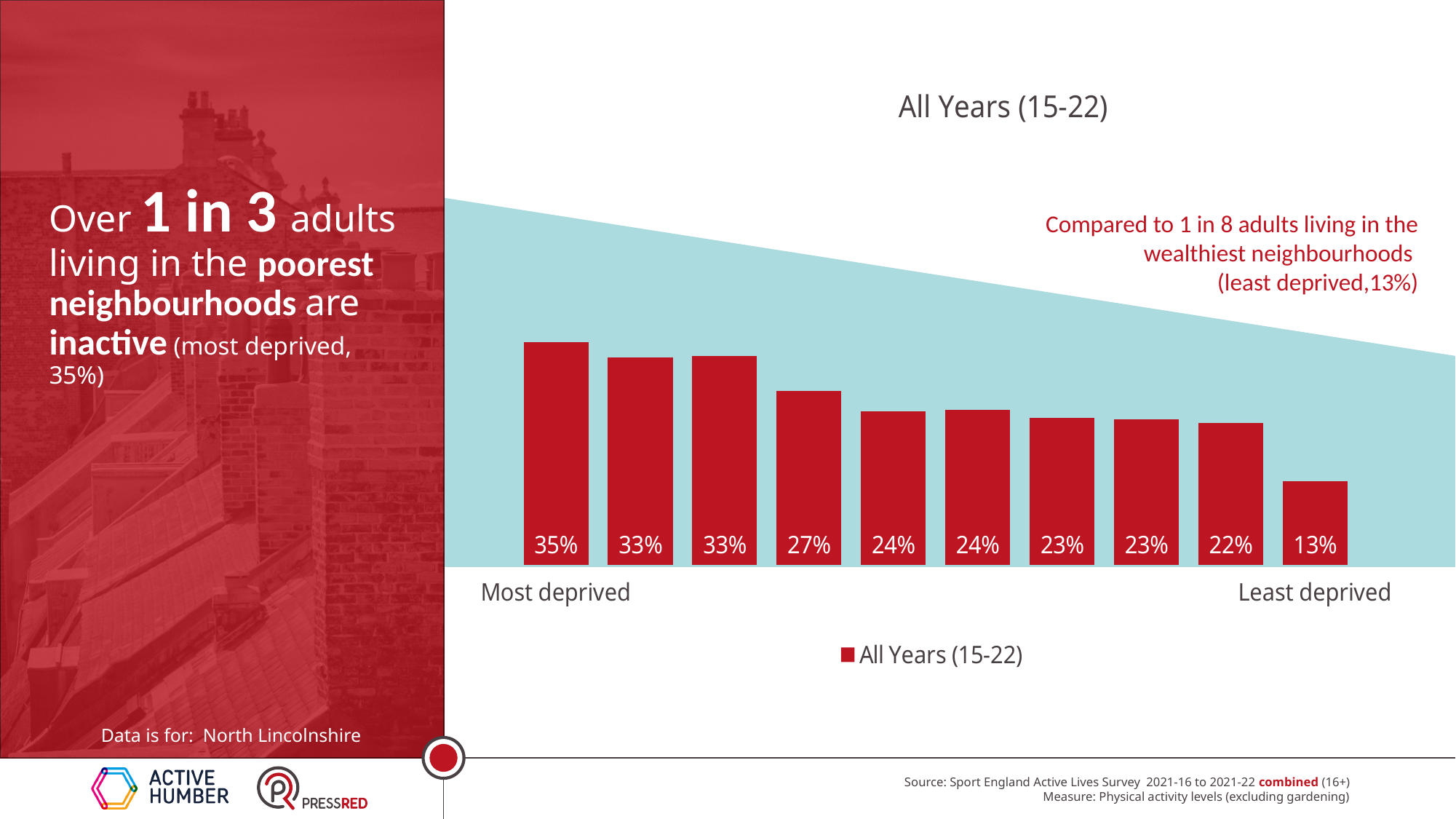
What kind of chart is shown on the slide? Bar chart What is the title of the chart? All Years (15-22) What is the value for the most deprived neighbourhoods in the chart? 35% Is the value for the most deprived neighbourhoods larger or smaller than the value for the least deprived neighbourhoods? Larger Do the values rise or fall moving from most deprived to least deprived? Fall Which bar has the highest value, most deprived or least deprived? Most deprived What is the value of the second bar from the left in the chart? 33% Which bar has the lowest value in the chart? Least deprived (13%) What is the difference between the most deprived and least deprived values? 22 percentage points What is the value for the least deprived neighbourhoods in the chart? 13% How many bars are plotted in the chart? 10 How many series does the legend list? 1